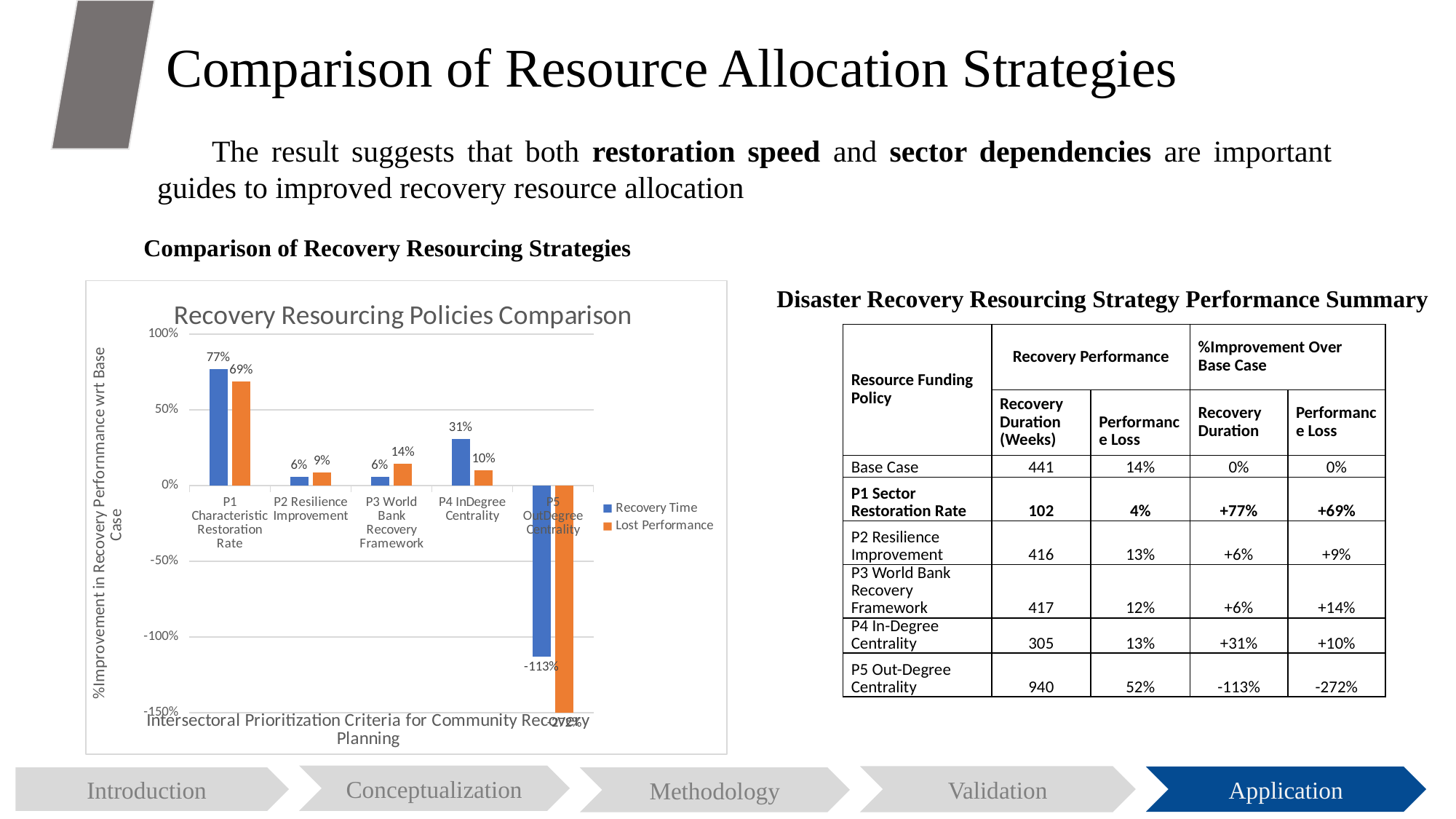
For P2 Resilience Improvement, which is larger: Recovery Time or Lost Performance? Lost Performance What is the title of the chart? Recovery Resourcing Policies Comparison What is the Lost Performance value for P3 World Bank Recovery Framework? 14% What is the Recovery Time value for P1 Characteristic Restoration Rate? 77% What type of chart is shown on the slide? Bar chart How many series does the legend of the chart list? 2 Which category has the highest Recovery Time value? P1 Characteristic Restoration Rate How many policy categories are plotted on the x axis of the chart? 5 What is the Recovery Time value for P5 OutDegree Centrality? -113% What is the difference between the Recovery Time and Lost Performance values for P1 Characteristic Restoration Rate? 8% Which category has the lowest Lost Performance value? P5 OutDegree Centrality What is the Recovery Time value for P4 InDegree Centrality? 31%